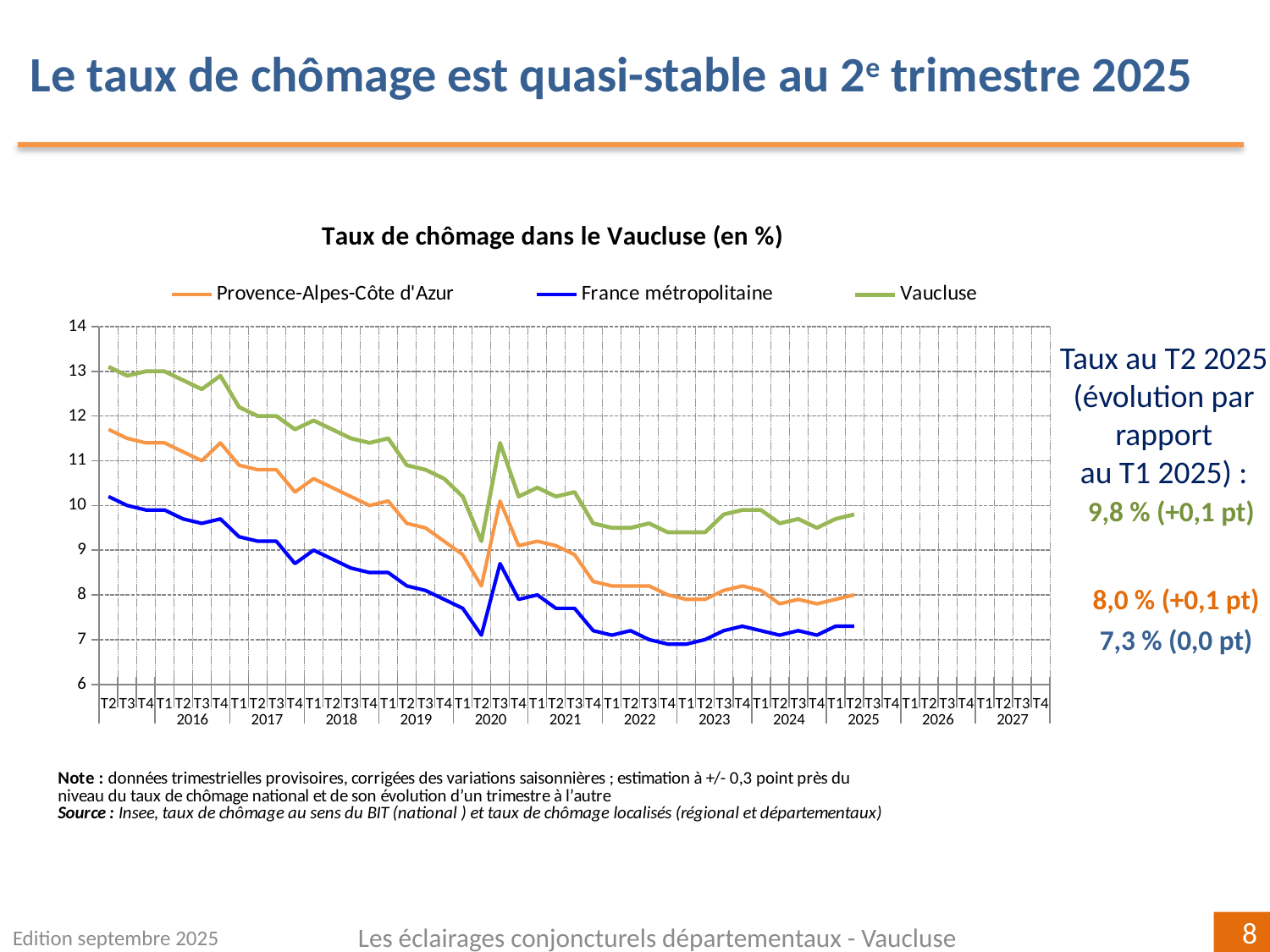
By how much did the Vaucluse unemployment rate change between T1 2025 and T2 2025? +0,1 pt What is the unemployment rate for Vaucluse at T2 2025? 9,8 % What kind of chart is shown on the slide? line chart What is the unemployment rate for France métropolitaine at T2 2025? 7,3 % Is the value for France métropolitaine at T2 2020 greater or less than 8? less Which series has the highest values across the whole period shown? Vaucluse What is the title of the chart? Taux de chômage dans le Vaucluse (en %) How many series does the legend of the chart list? 3 What is the difference between the Vaucluse rate and the France métropolitaine rate at T2 2025? 2,5 points At T2 2025, which is higher: the rate for Vaucluse or the rate for Provence-Alpes-Côte d'Azur? Vaucluse Overall, does the Vaucluse unemployment rate rise or fall from 2016 to 2025? fall What is the unemployment rate for Provence-Alpes-Côte d'Azur at T2 2025? 8,0 %